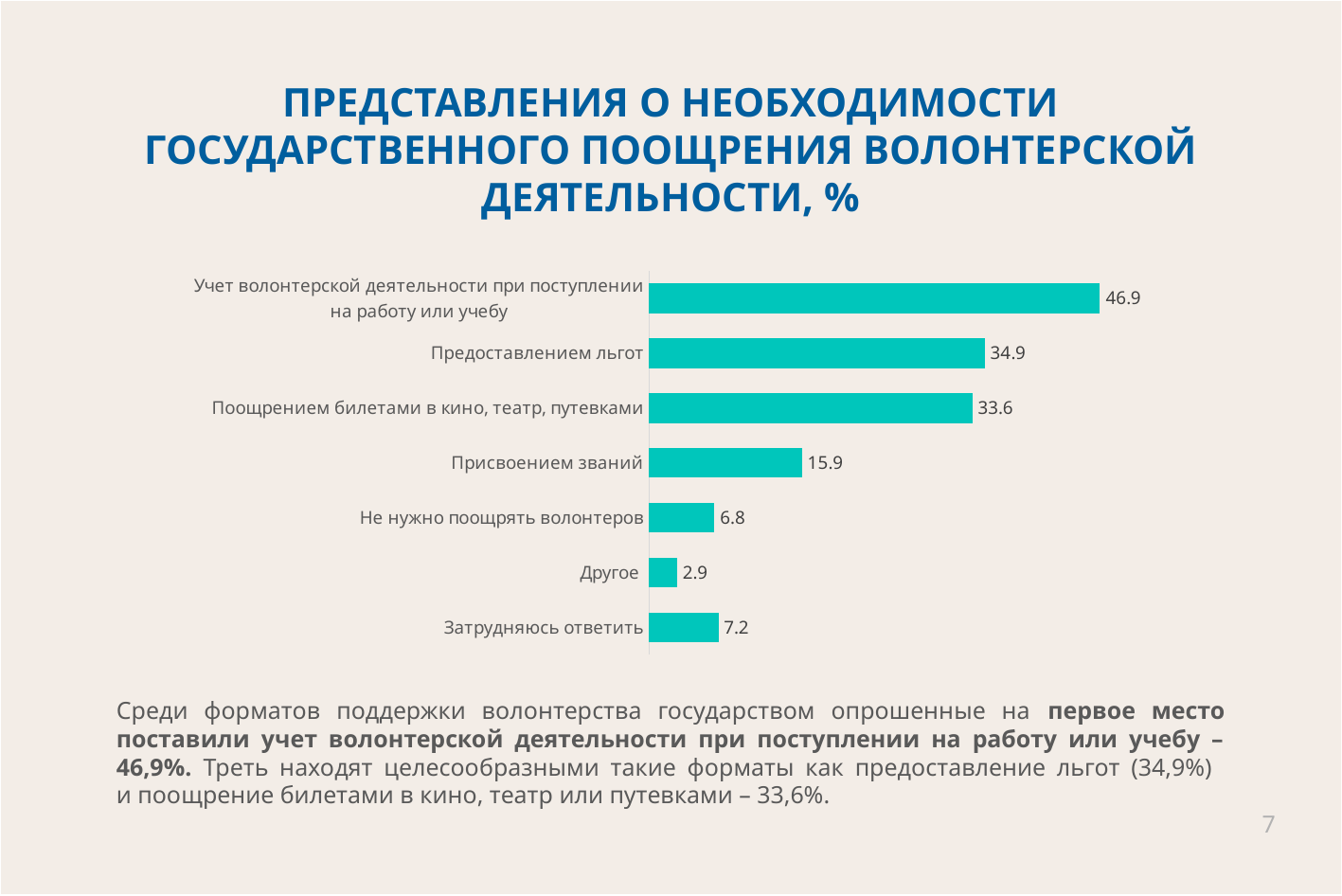
Which category has the highest value? Учет волонтерской деятельности при поступлении на работу или учебу What colour are the bars in the chart? Teal What is the value for «Затрудняюсь ответить»? 7.2 How many categories are shown in the chart? 7 What kind of chart is shown on the slide? Bar chart What is the difference between the values for «Предоставлением льгот» and «Поощрением билетами в кино, театр, путевками»? 1.3 Which category has the lowest value? Другое What is the difference between the values for «Учет волонтерской деятельности при поступлении на работу или учебу» and «Присвоением званий»? 31.0 Which is larger: the value for «Затрудняюсь ответить» or for «Не нужно поощрять волонтеров»? Затрудняюсь ответить What is the value for «Присвоением званий»? 15.9 What is the value for «Не нужно поощрять волонтеров»? 6.8 What is the value for «Предоставлением льгот»? 34.9